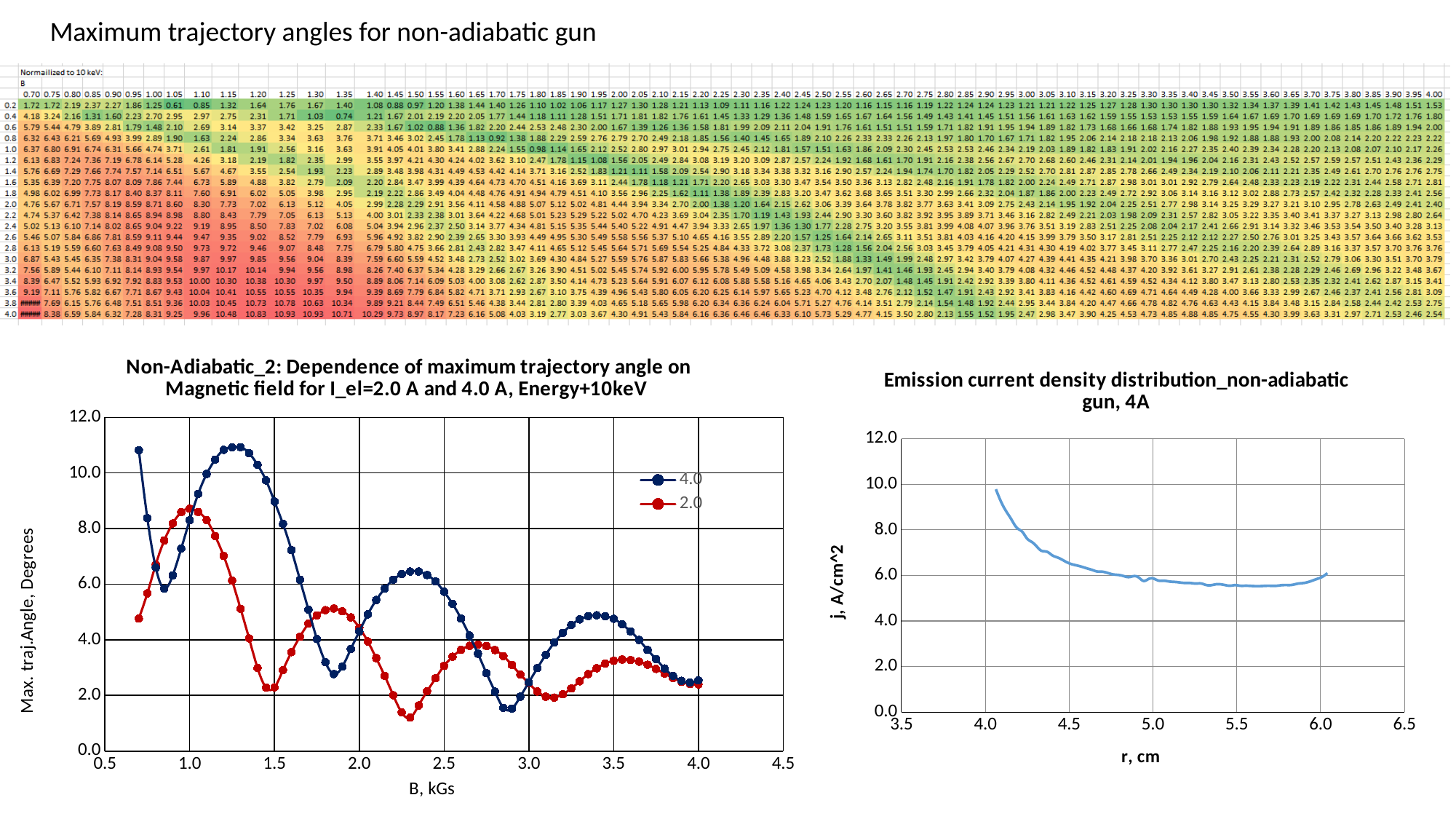
On the left chart (maximum trajectory angle vs magnetic field), do the successive peak values of the 4.0 series rise or fall as B increases? fall How many series does the legend of the left chart (maximum trajectory angle vs magnetic field) list? 2 What is the x-axis label of the right chart, 'Emission current density distribution_non-adiabatic gun, 4A'? r, cm On the right chart (emission current density distribution), is the value of j at r = 4.5 cm greater or less than 6.0? greater On the left chart (maximum trajectory angle vs magnetic field), which series reaches the highest angle anywhere on the chart? 4.0 What are the two legend entries on the left chart (maximum trajectory angle vs magnetic field)? 4.0 and 2.0 On the left chart (maximum trajectory angle vs magnetic field), which series has the higher value at B = 1.85 kGs, 4.0 or 2.0? 2.0 What kind of chart is the left chart, 'Non-Adiabatic_2: Dependence of maximum trajectory angle on Magnetic field'? line chart On the left chart (maximum trajectory angle vs magnetic field), is the value of the 4.0 series at B = 1.25 kGs greater or less than 10.0? greater On the right chart (emission current density distribution), does j rise or fall as r increases from 4.0 cm to 5.5 cm? fall On the left chart (maximum trajectory angle vs magnetic field), which series has the higher value at B = 3.4 kGs, 4.0 or 2.0? 4.0 On the left chart (maximum trajectory angle vs magnetic field), is the value of the 2.0 series at B = 2.3 kGs greater or less than 2.0? less